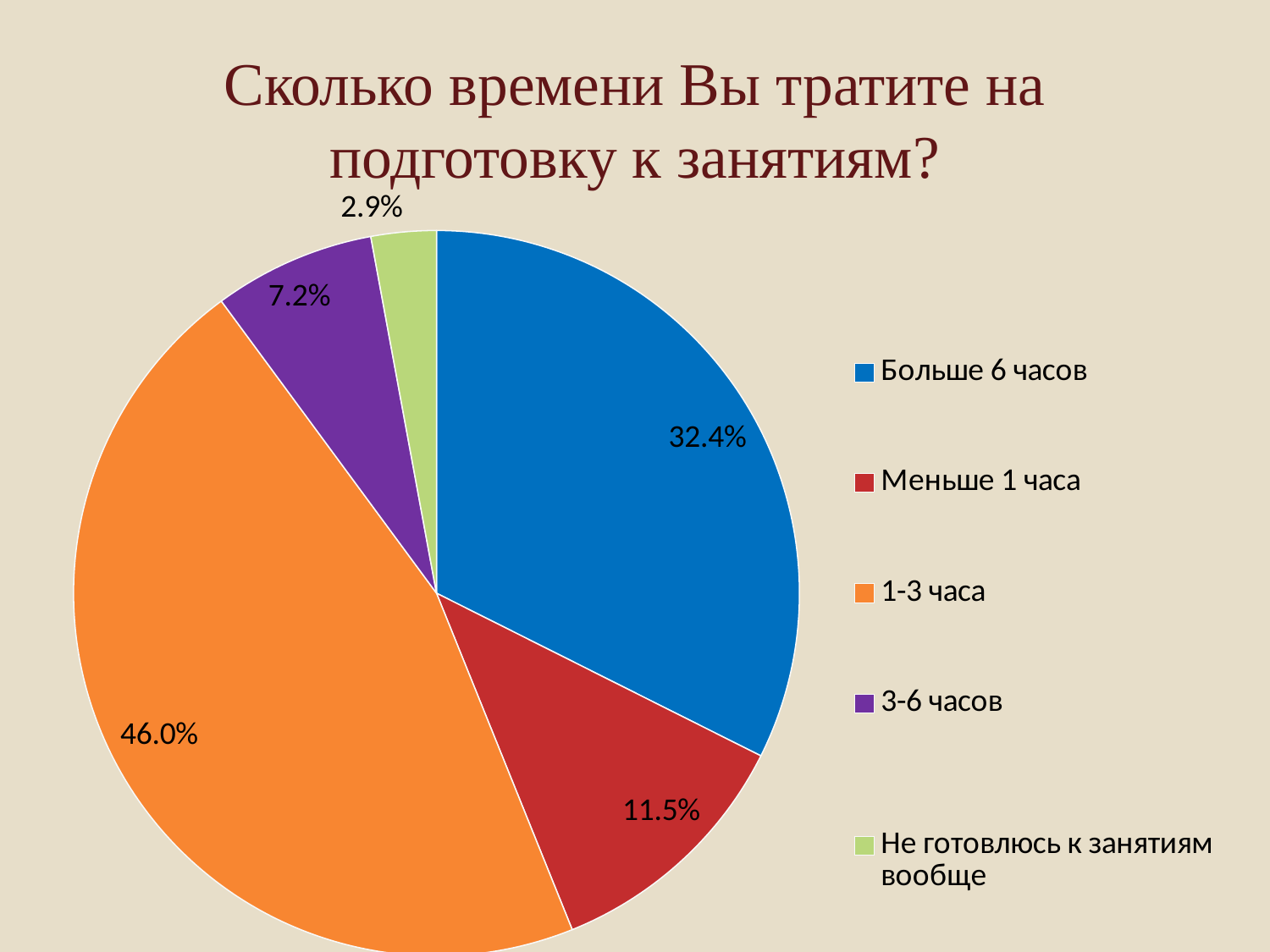
What percentage is labelled for 'Меньше 1 часа'? 11.5% What share is shown for 'Не готовлюсь к занятиям вообще'? 2.9% What share of the pie does the '1-3 часа' slice represent? 46.0% Which category has the largest slice of the pie? 1-3 часа What type of chart is shown on the slide? Pie chart Which is larger, the share for 'Меньше 1 часа' or for '3-6 часов'? Меньше 1 часа How many categories does the pie chart show? 5 What is the value for '3-6 часов'? 7.2% What is the value shown for 'Больше 6 часов'? 32.4% What colour is the slice for '1-3 часа'? Orange Which category has the smallest slice of the pie? Не готовлюсь к занятиям вообще What is the difference between the '1-3 часа' and 'Больше 6 часов' shares? 13.6%